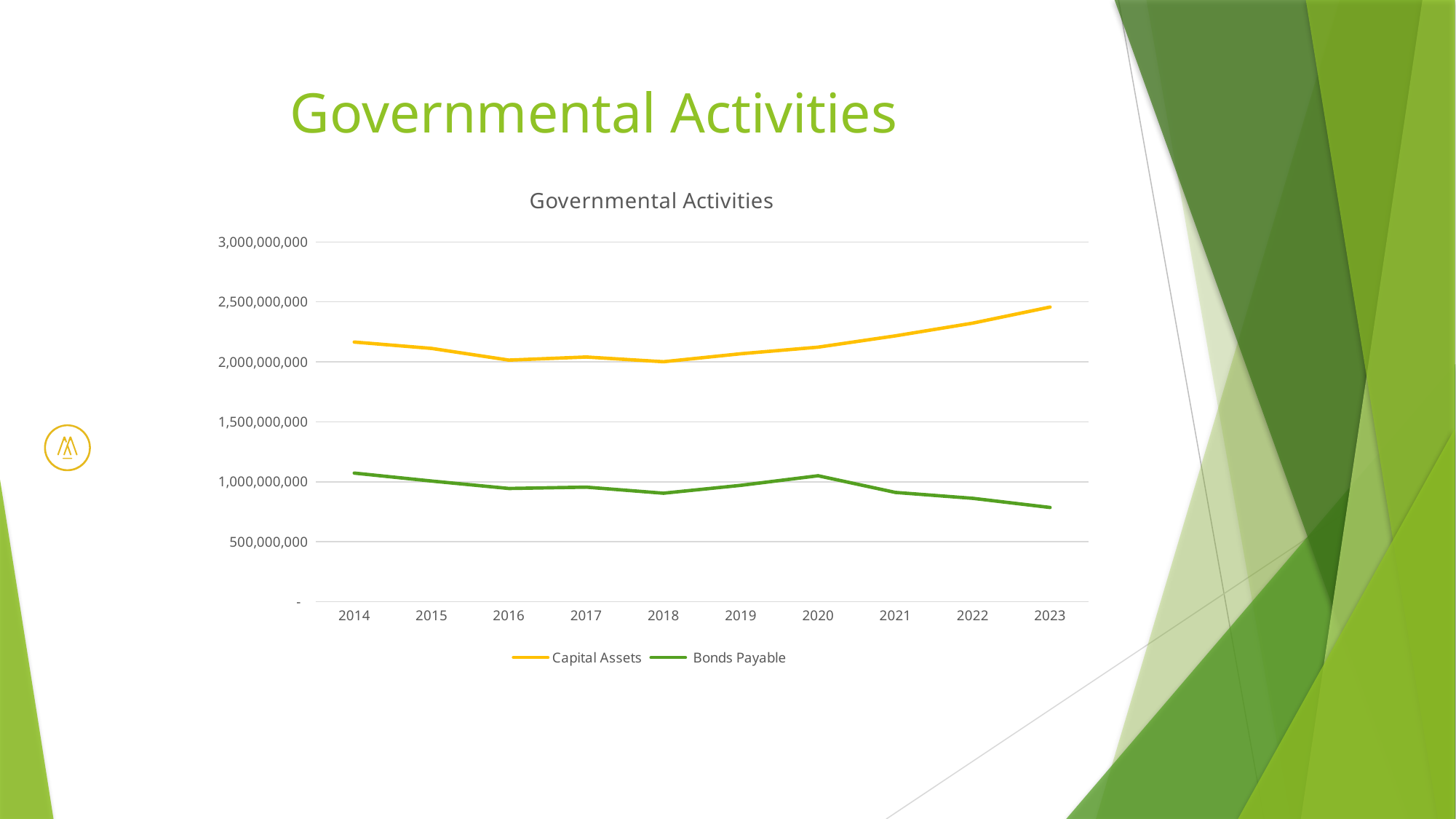
In which year is Capital Assets highest? 2023 In which year is Bonds Payable lowest? 2023 How many years are plotted along the x axis? 10 What is the title of the chart? Governmental Activities How many series does the legend list? 2 What kind of chart is shown on the slide? Line chart Is the value for Bonds Payable in 2023 greater or less than 1,000,000,000? less Which series has the larger value in 2023, Capital Assets or Bonds Payable? Capital Assets Is the value for Capital Assets in 2014 greater or less than 2,000,000,000? greater Which is larger for Bonds Payable, the value in 2020 or the value in 2023? 2020 Is the value for Capital Assets in 2023 greater or less than 2,000,000,000? greater Does Capital Assets rise or fall from 2018 to 2023? Rise